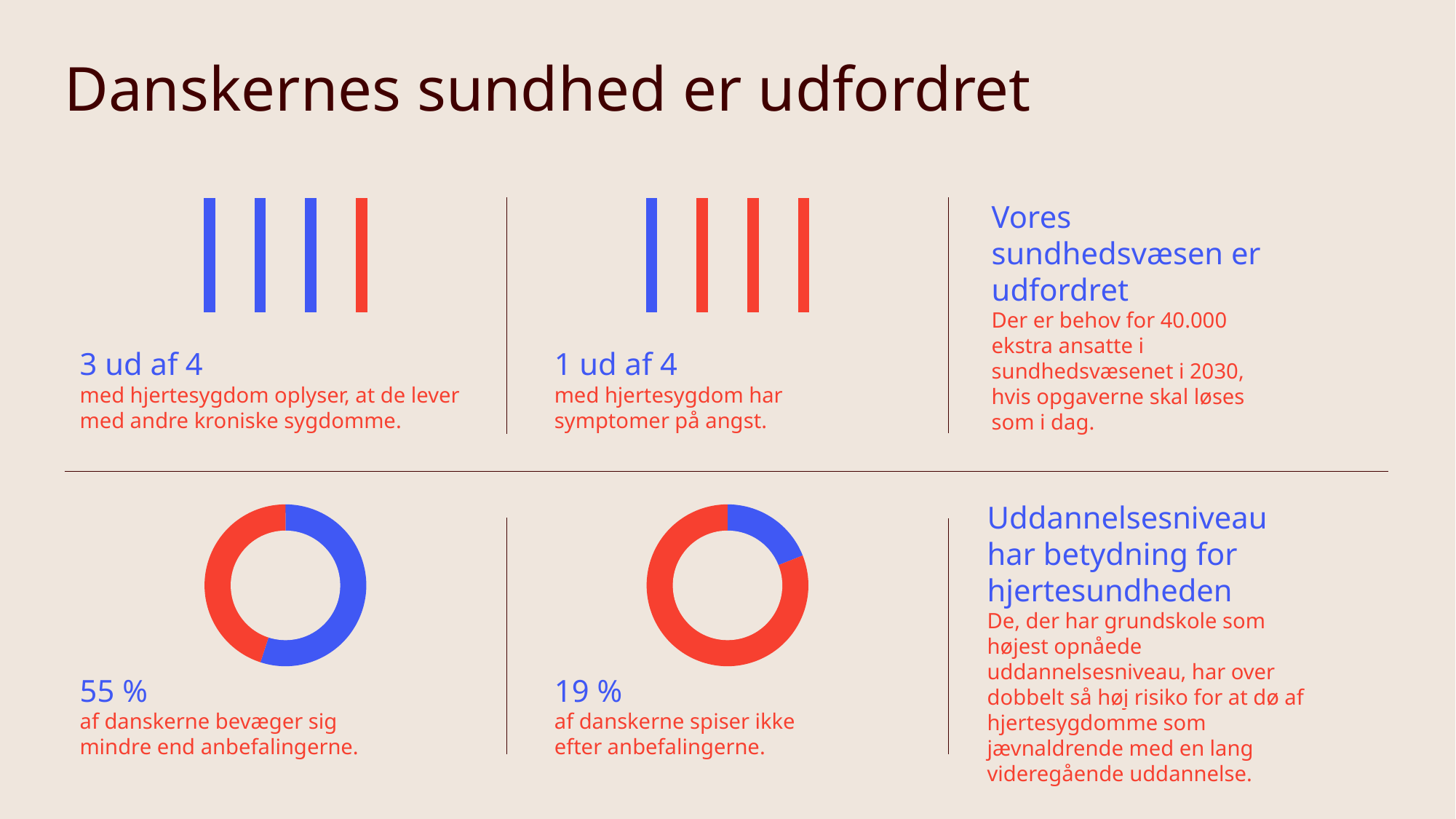
How many bars are red in the top-middle pictogram labelled "1 ud af 4"? 3 In the bottom-middle donut chart, what share of Danes do not eat according to the recommendations? 19 % According to the top-middle pictogram, how many out of 4 people with heart disease have symptoms of anxiety? 1 ud af 4 How many bars are shown in the top-left pictogram labelled "3 ud af 4"? 4 In the bottom-left donut chart, which slice is larger, the blue one or the red one? blue What kind of chart is shown in the bottom-left panel labelled "55 %"? donut chart In the bottom-middle donut chart, which slice is larger, the blue one or the red one? red How many bars are blue in the top-left pictogram labelled "3 ud af 4"? 3 What is the title of the slide containing the charts? Danskernes sundhed er udfordret Is the blue share in the bottom-middle donut chart greater or less than 50%? less In the bottom-left donut chart, what share of Danes move less than the recommendations? 55 % What kind of chart is shown in the bottom-middle panel labelled "19 %"? donut chart